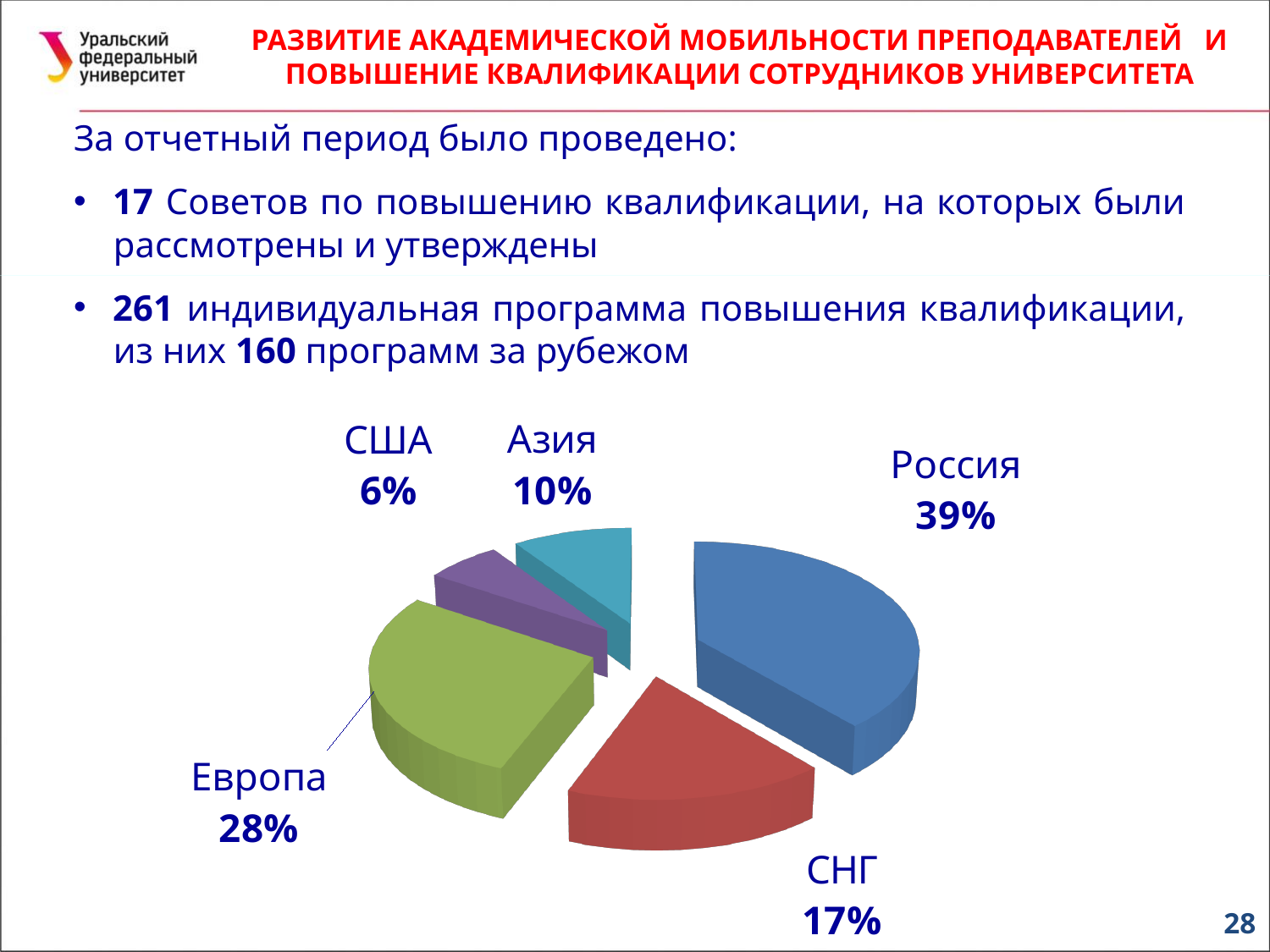
What is the difference in percentage points between Россия and Европа? 11 What kind of chart is shown on the slide? pie chart Which category has the smallest slice of the pie? США What share of the pie does Россия have? 39% Which category has the largest slice of the pie? Россия What share of the pie does Азия have? 10% Which is larger, the share for СНГ or the share for Азия? СНГ What colour is the slice for Европа? green What share of the pie does США have? 6% How many slices does the pie chart have? 5